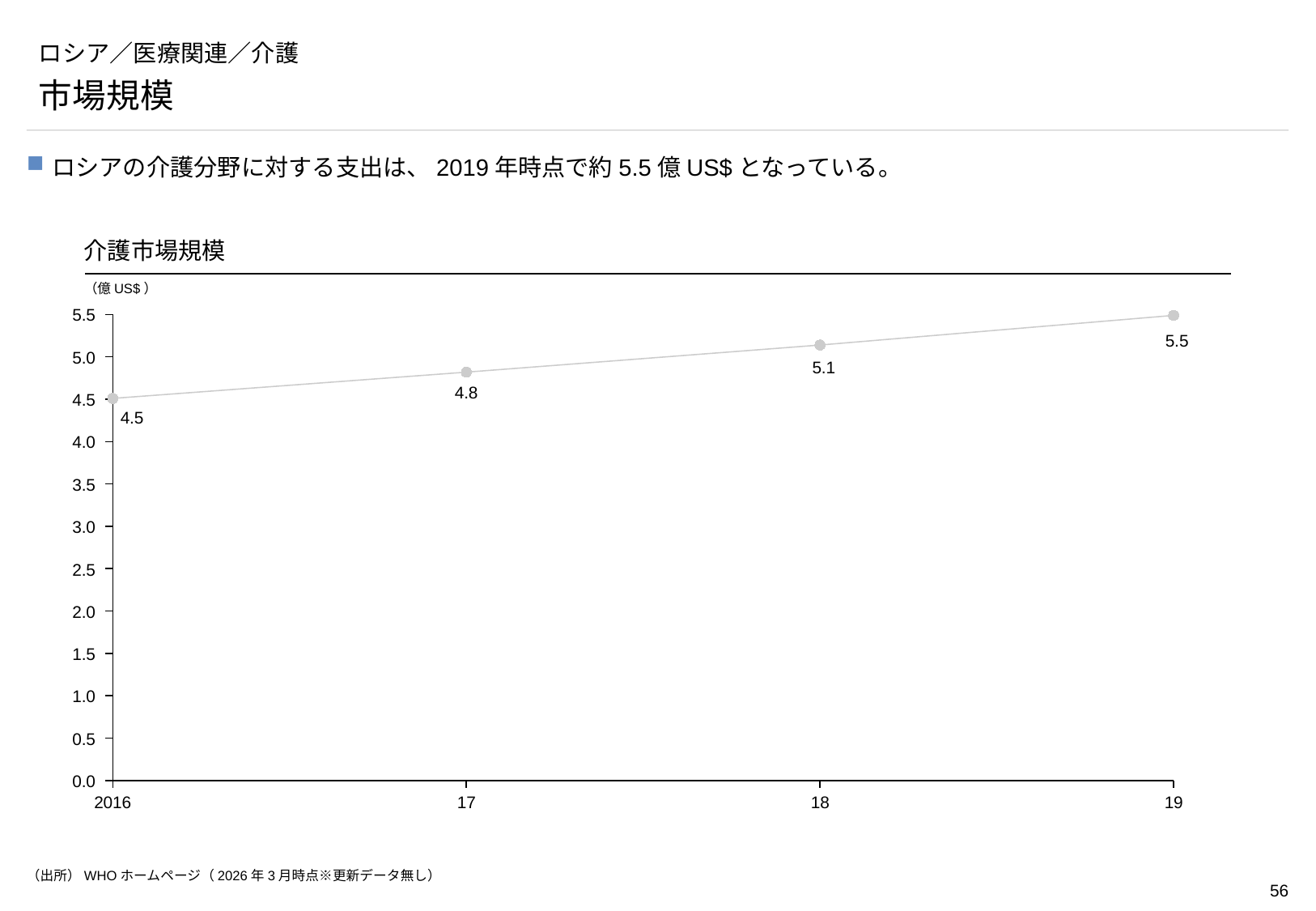
Which year has the highest value? 19 What is the value for 17? 4.8 Which year has the lowest value? 2016 Is the value for 2016 greater or less than 4.0? greater What is the difference between the values for 19 and 2016? 1.0 How many data points are plotted on the chart? 4 What is the value for 18? 5.1 Do the values rise or fall from 2016 to 19? rise What kind of chart is shown? line chart Which is larger, the value for 17 or the value for 18? 18 What is the value for 19? 5.5 What is the value for 2016? 4.5